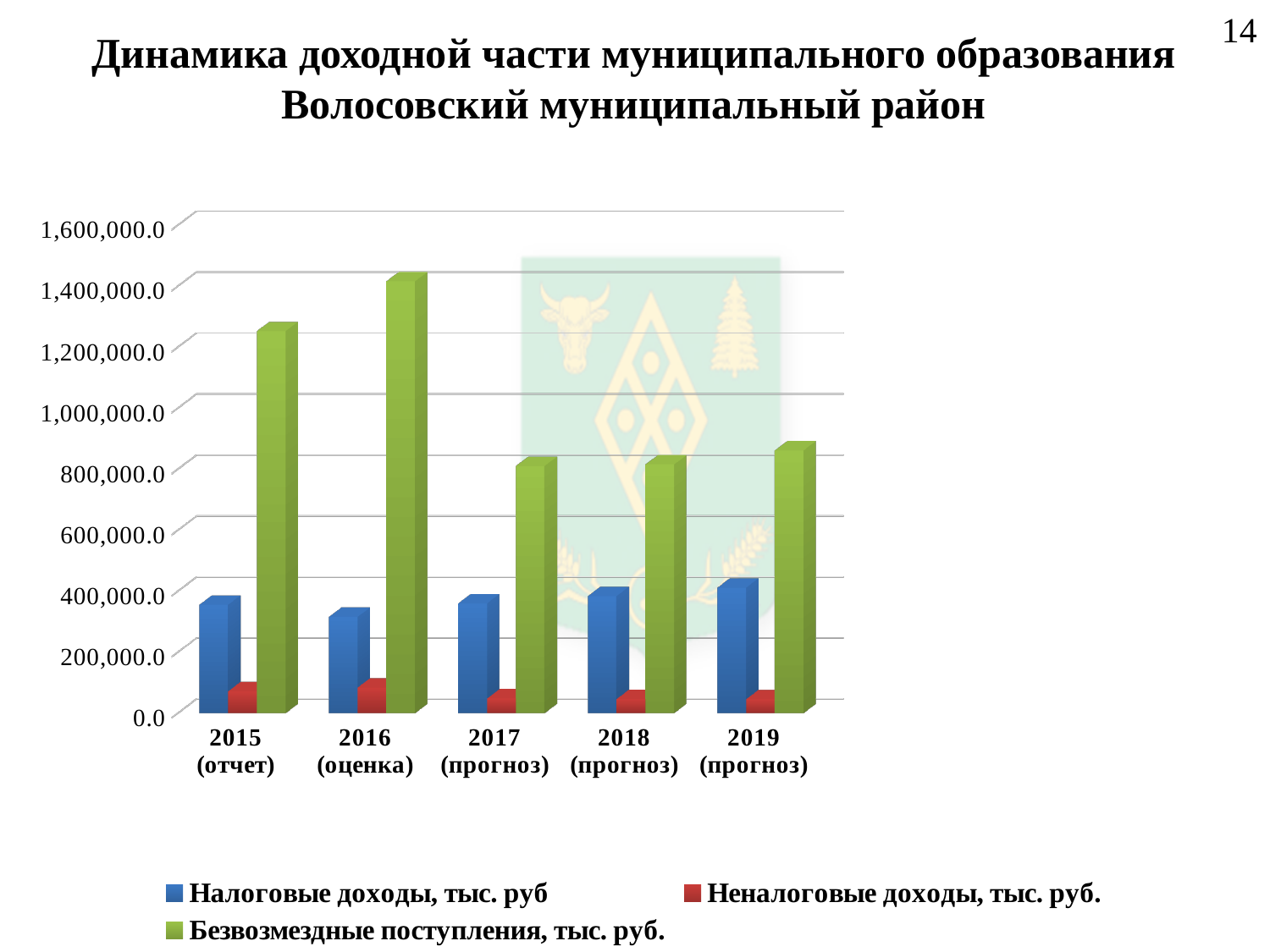
Is the value for Налоговые доходы, тыс. руб in 2019 (прогноз) greater or less than 200,000.0? greater Is the value for Безвозмездные поступления, тыс. руб. in 2016 (оценка) greater or less than 1,200,000.0? greater Is the value for Безвозмездные поступления, тыс. руб. in 2017 (прогноз) greater or less than 1,000,000.0? less In which year is the value for Безвозмездные поступления, тыс. руб. the highest? 2016 (оценка) Which series is shown in green in the legend? Безвозмездные поступления, тыс. руб. Which is larger for Налоговые доходы, тыс. руб: the value in 2016 (оценка) or in 2018 (прогноз)? 2018 (прогноз) In which year is the value for Налоговые доходы, тыс. руб the lowest? 2016 (оценка) What kind of chart is shown on the slide? bar chart How many year categories are shown on the x axis? 5 Which is larger for Безвозмездные поступления, тыс. руб.: the value in 2015 (отчет) or in 2016 (оценка)? 2016 (оценка) How many series does the legend list? 3